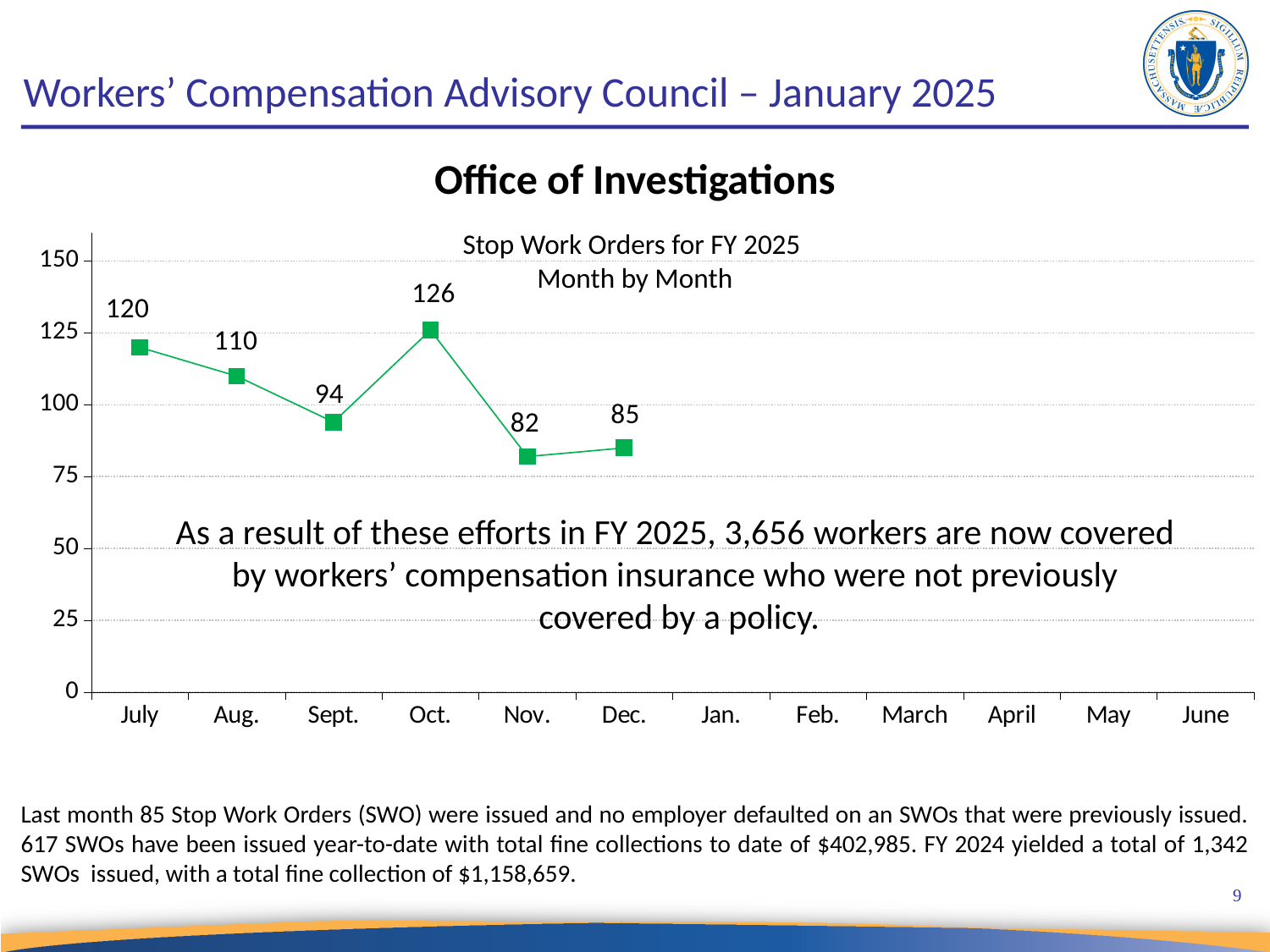
What is the value for October in the Stop Work Orders for FY 2025 chart? 126 How many months have data points plotted on the chart? 6 Which month has the highest number of Stop Work Orders on the chart? Oct. How many Stop Work Orders were issued in September according to the chart? 94 What is the difference between the October value and the November value? 44 What is the value plotted for November? 82 Which is larger, the value for December or the value for September? Sept. Which month has the lowest number of Stop Work Orders on the chart? Nov. What kind of chart is shown on the slide? line chart Is the value for July greater or less than 100? greater What is the difference between the July value and the August value? 10 What is the title of the chart? Stop Work Orders for FY 2025 Month by Month